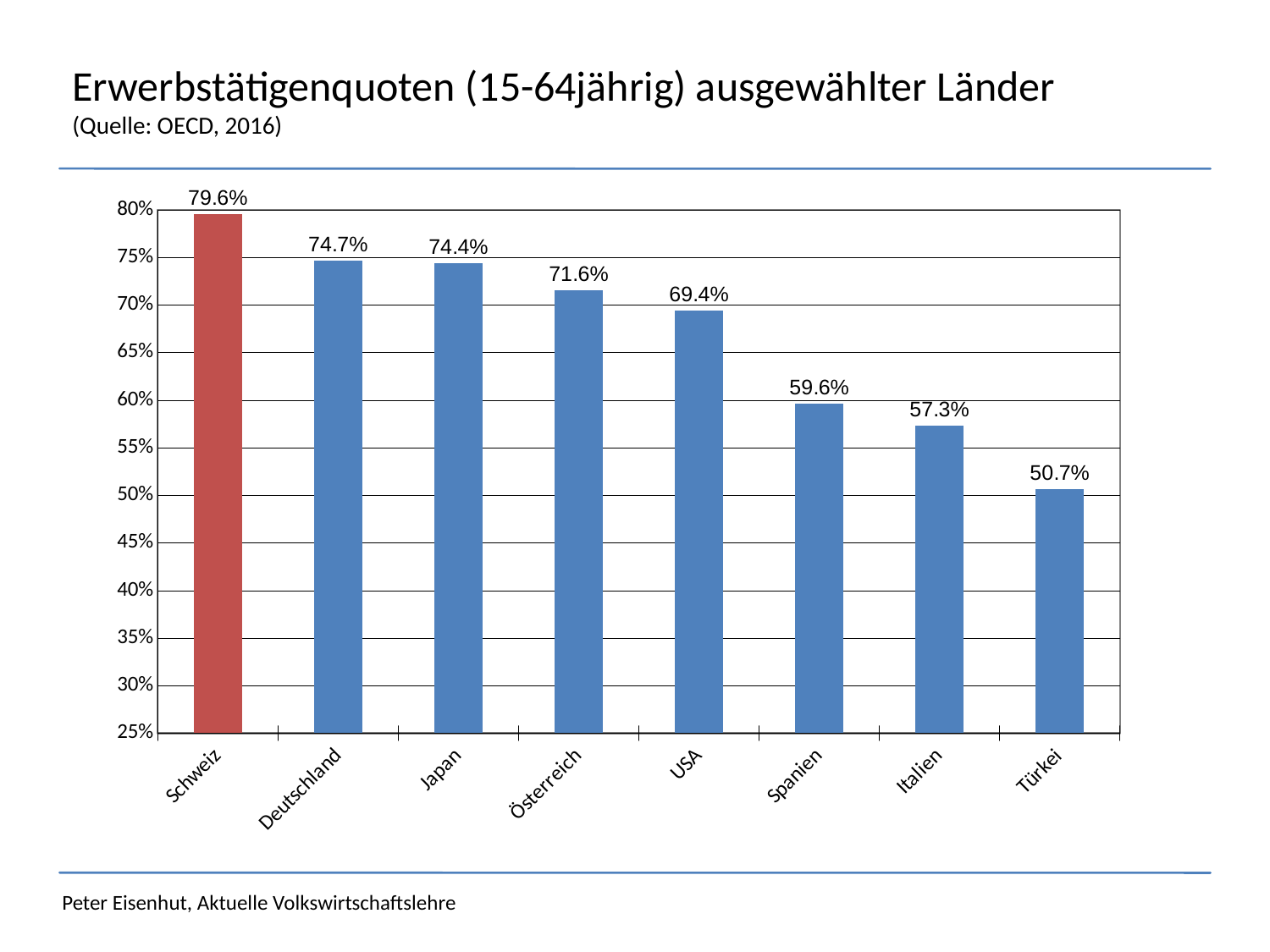
What is the value shown for Spanien? 59.6% What is the value shown for Österreich? 71.6% How many countries are shown in the chart? 8 What kind of chart is shown on the slide? bar chart What is the difference between the values for USA and Italien? 12.1% Which country has the lowest employment rate in the chart? Türkei Which country has the highest employment rate in the chart? Schweiz What is the employment rate shown for Schweiz? 79.6% Which has a higher value, Japan or USA? Japan What is the difference between the values for Schweiz and Türkei? 28.9% Is the value for Spanien greater or less than 60%? less Which bar is coloured red rather than blue? Schweiz